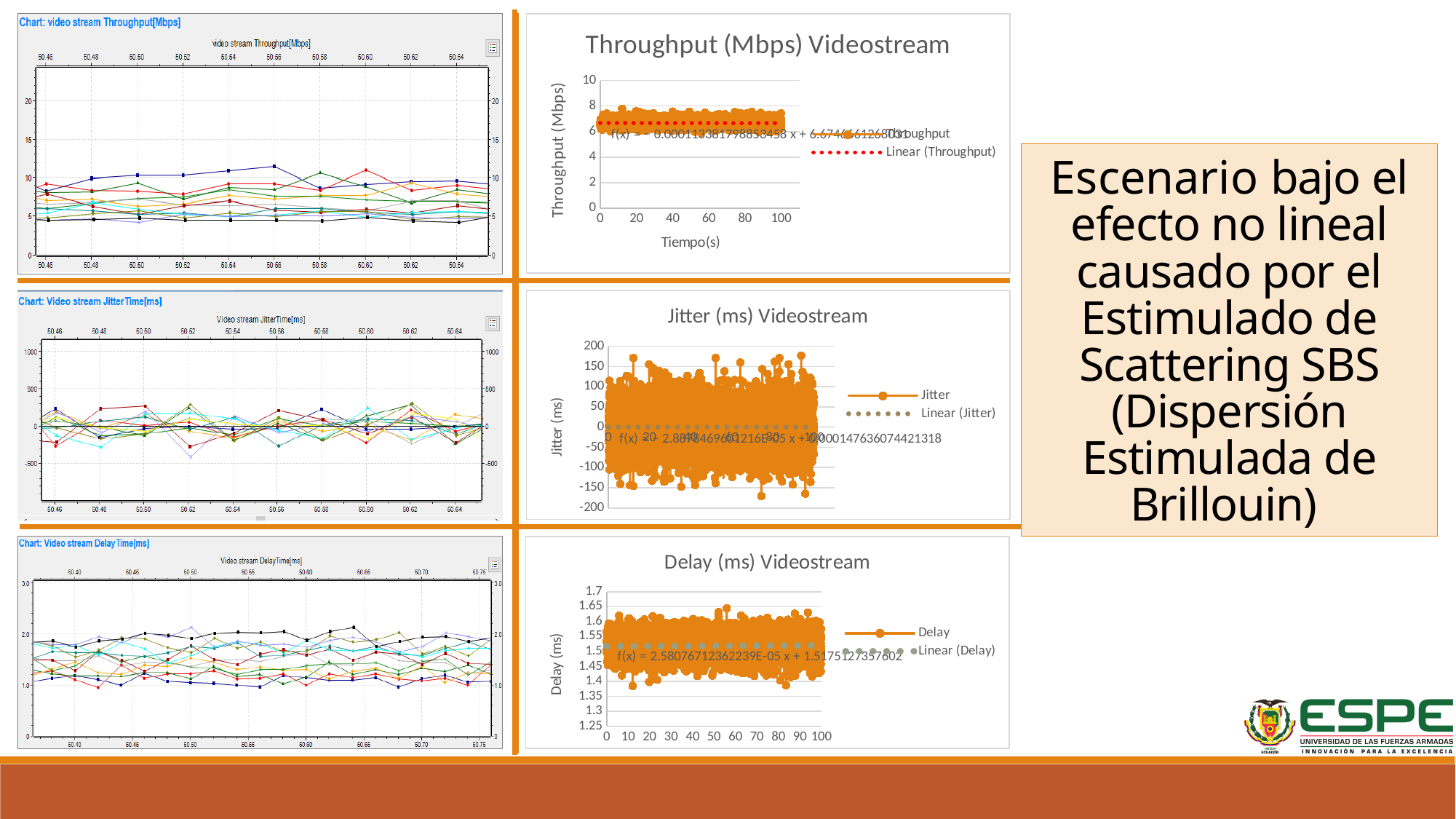
On the 'Delay (ms) Videostream' chart, are the plotted Delay values greater or less than 1.7? less On the 'Throughput (Mbps) Videostream' chart, does the Linear (Throughput) trend line clearly rise, clearly fall, or stay roughly flat across the x axis? roughly flat On the 'Throughput (Mbps) Videostream' chart, how many series does the legend list? 2 What kind of chart is the 'Delay (ms) Videostream' chart? line chart with markers On the 'Delay (ms) Videostream' chart, how many series does the legend list? 2 On the 'Throughput (Mbps) Videostream' chart, are the plotted Throughput values greater or less than 4? greater On the 'Jitter (ms) Videostream' chart, how many series does the legend list? 2 On the 'Throughput (Mbps) Videostream' chart, what is the title of the x axis? Tiempo(s) On the 'Jitter (ms) Videostream' chart, what are the two legend entries? Jitter and Linear (Jitter) On the 'Delay (ms) Videostream' chart, are the plotted Delay values greater or less than 1.3? greater